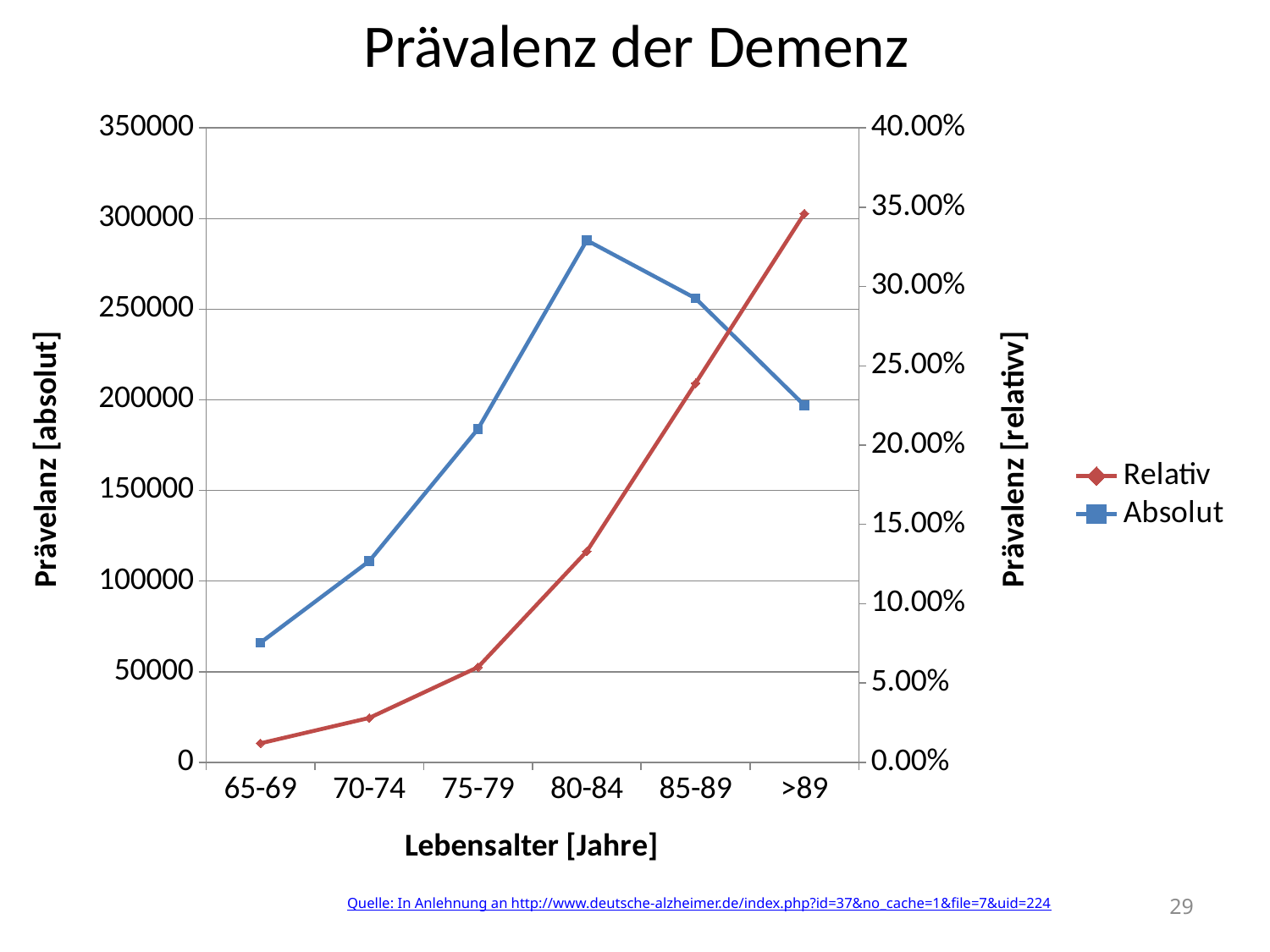
Is the Absolut value for 75-79 greater or less than 150000? greater What is the title of the chart? Prävalenz der Demenz Which age group has the highest value for the Absolut series? 80-84 Is the Absolut value for 80-84 greater or less than 250000? greater Which age group has the highest value for the Relativ series? >89 Is the Relativ value for 85-89 greater or less than 20.00%? greater How many series does the legend list? 2 How many age groups are plotted along the x axis? 6 Which age group has the lowest value for the Absolut series? 65-69 Do the values of the Relativ series rise or fall from 65-69 to >89? rise What kind of chart is shown on the slide? line chart